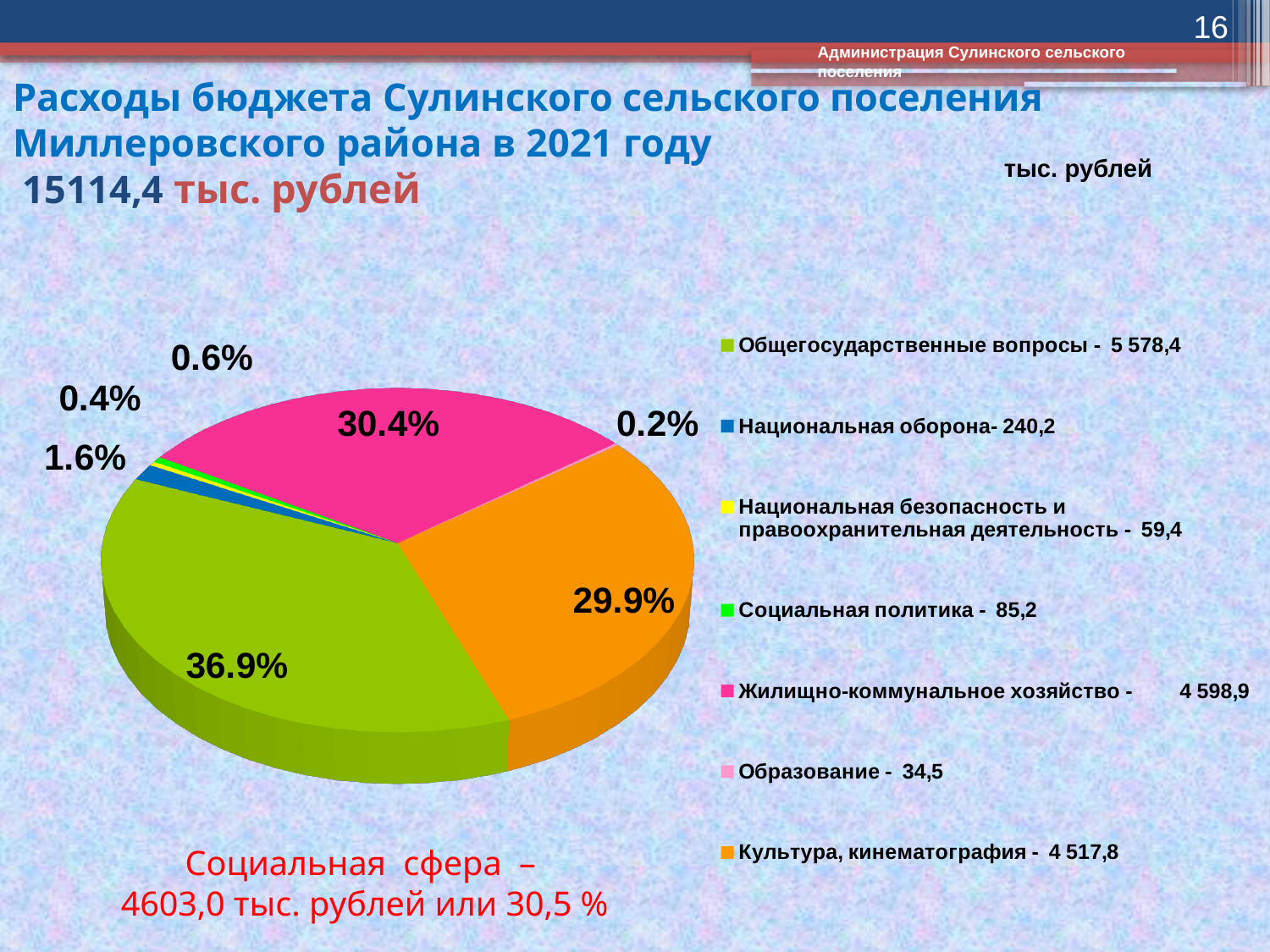
Which is larger: Жилищно-коммунальное хозяйство or Культура, кинематография? Жилищно-коммунальное хозяйство What is the difference between the values for Общегосударственные вопросы and Жилищно-коммунальное хозяйство? 979,5 What total budget expenditure is stated in the slide title? 15114,4 тыс. рублей What is the value for Общегосударственные вопросы shown in the legend? 5 578,4 What is the value for Жилищно-коммунальное хозяйство shown in the legend? 4 598,9 What percentage share of the pie is labelled for the largest slice? 36.9% What percentage share is labelled for the Культура, кинематография slice? 29.9% How many categories does the legend of the pie chart list? 7 What kind of chart is shown on the slide? pie chart Which category has the smallest value in the legend? Образование What is the value for Образование shown in the legend? 34,5 Which category has the largest share of the pie? Общегосударственные вопросы